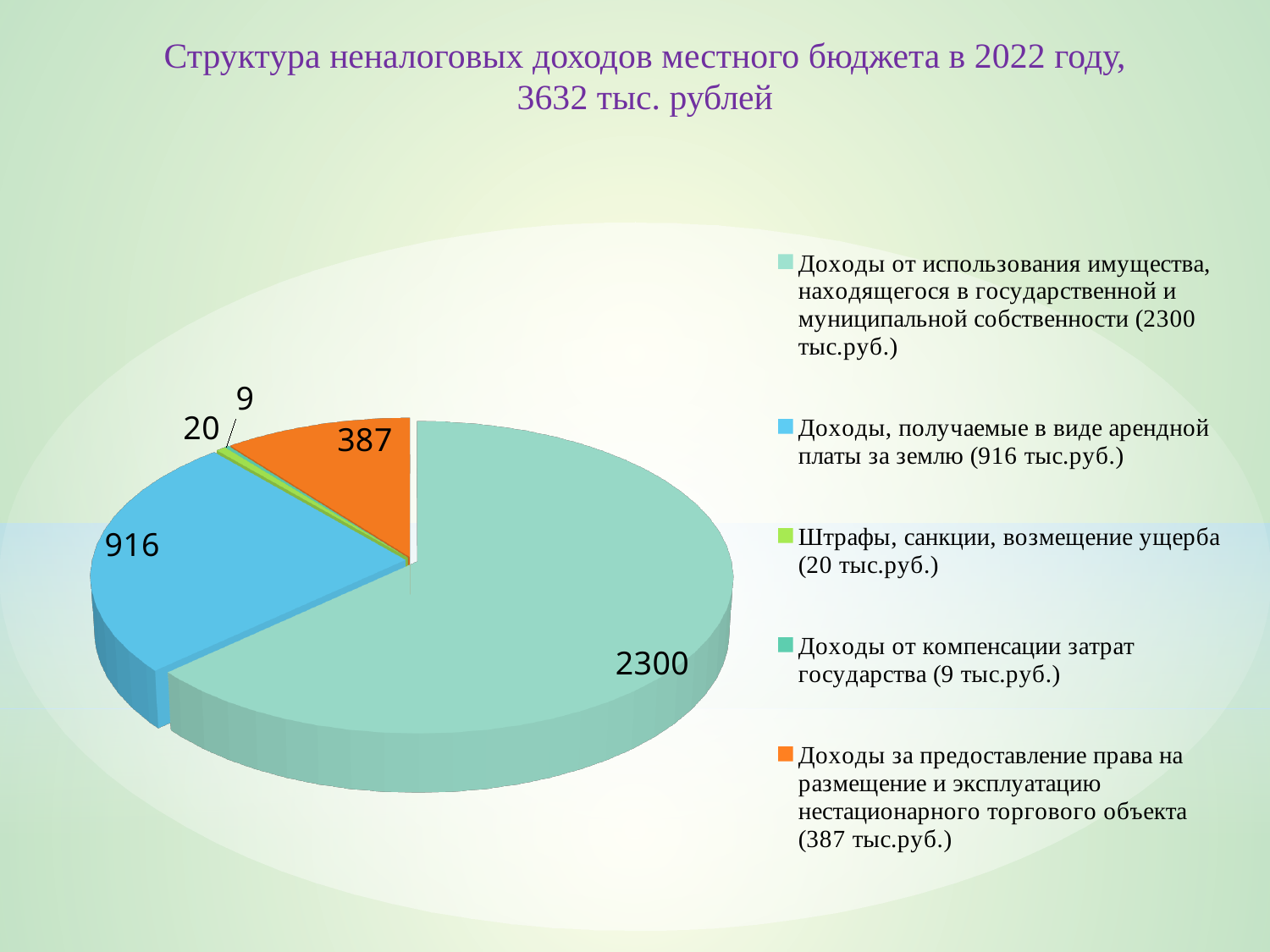
What is the value for "Доходы от компенсации затрат государства"? 9 What is the value for "Доходы за предоставление права на размещение и эксплуатацию нестационарного торгового объекта"? 387 Which is larger: the value for "Доходы, получаемые в виде арендной платы за землю" or the value for "Доходы за предоставление права на размещение и эксплуатацию нестационарного торгового объекта"? Доходы, получаемые в виде арендной платы за землю What is the difference between the value for "Доходы от использования имущества, находящегося в государственной и муниципальной собственности" and the value for "Доходы, получаемые в виде арендной платы за землю"? 1384 What is the value for "Доходы, получаемые в виде арендной платы за землю"? 916 How many categories does the pie chart have? 5 Which category has the largest slice of the pie? Доходы от использования имущества, находящегося в государственной и муниципальной собственности What is the total of all the slices in the pie chart? 3632 Which category has the smallest slice of the pie? Доходы от компенсации затрат государства What is the value for "Штрафы, санкции, возмещение ущерба"? 20 What type of chart is shown on the slide? pie chart What colour is the slice for "Доходы, получаемые в виде арендной платы за землю"? blue